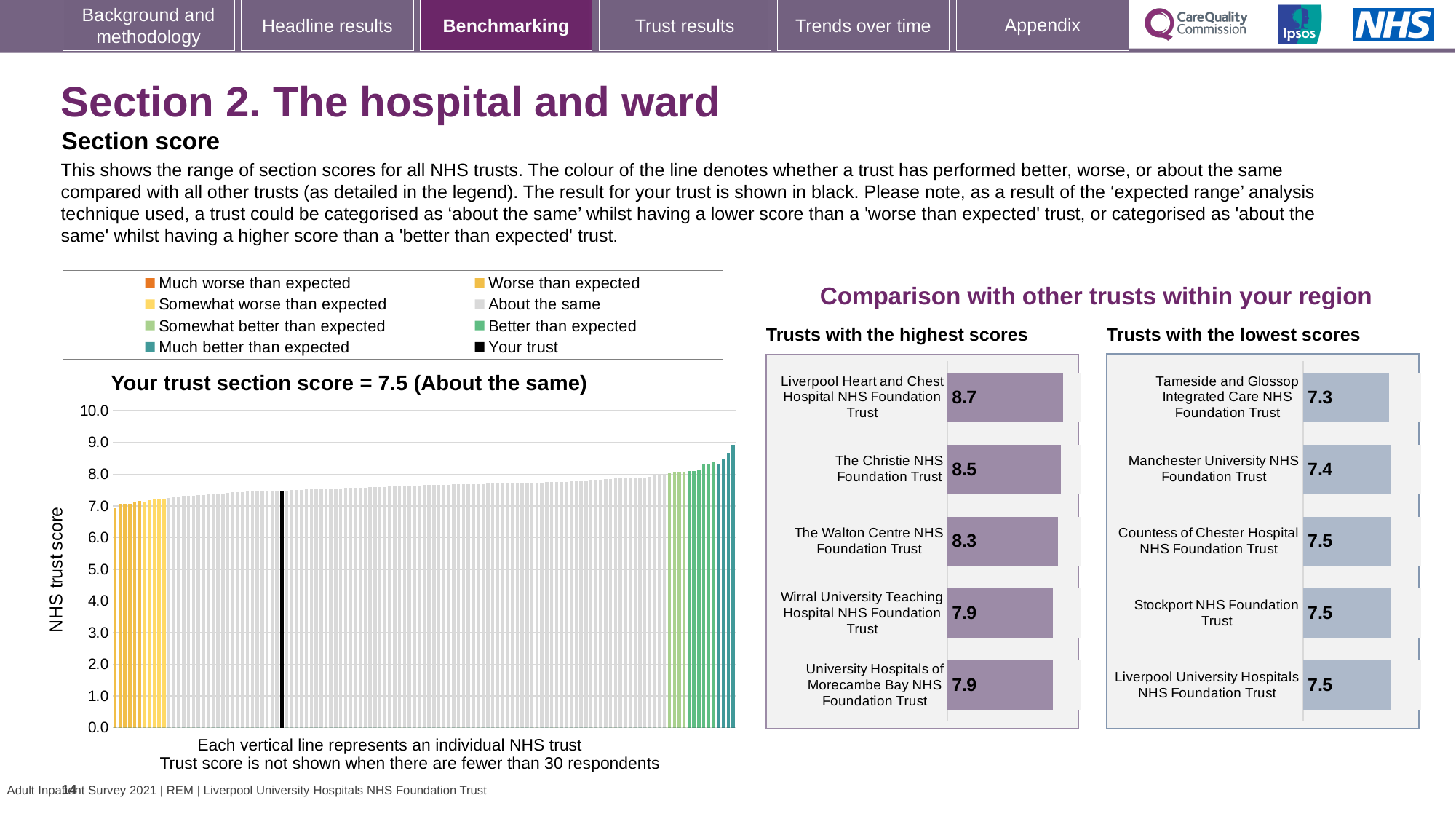
In the 'Your trust section score' chart, what is the section score for your trust, as stated in the chart title? 7.5 In the 'Your trust section score' chart, what is the label on the vertical axis? NHS trust score In the 'Your trust section score' chart, is the value of the rightmost (highest) bar greater or less than 8.0? greater In the 'Trusts with the highest scores' chart, what is the score for The Christie NHS Foundation Trust? 8.5 In the 'Your trust section score' chart, how many entries does the legend list? 8 In the 'Your trust section score' chart, what kind of chart is shown? Bar chart In the 'Trusts with the highest scores' chart, which trust has the highest score? Liverpool Heart and Chest Hospital NHS Foundation Trust In the 'Trusts with the highest scores' chart, what is the difference between the scores of Liverpool Heart and Chest Hospital NHS Foundation Trust and The Walton Centre NHS Foundation Trust? 0.4 In the 'Trusts with the highest scores' chart, how many trusts are listed? 5 In the 'Trusts with the lowest scores' chart, which has the larger score: Manchester University NHS Foundation Trust or Tameside and Glossop Integrated Care NHS Foundation Trust? Manchester University NHS Foundation Trust In the 'Your trust section score' chart, do the bars rise or fall from left to right along the x axis? Rise In the 'Trusts with the lowest scores' chart, which trust has the lowest score? Tameside and Glossop Integrated Care NHS Foundation Trust